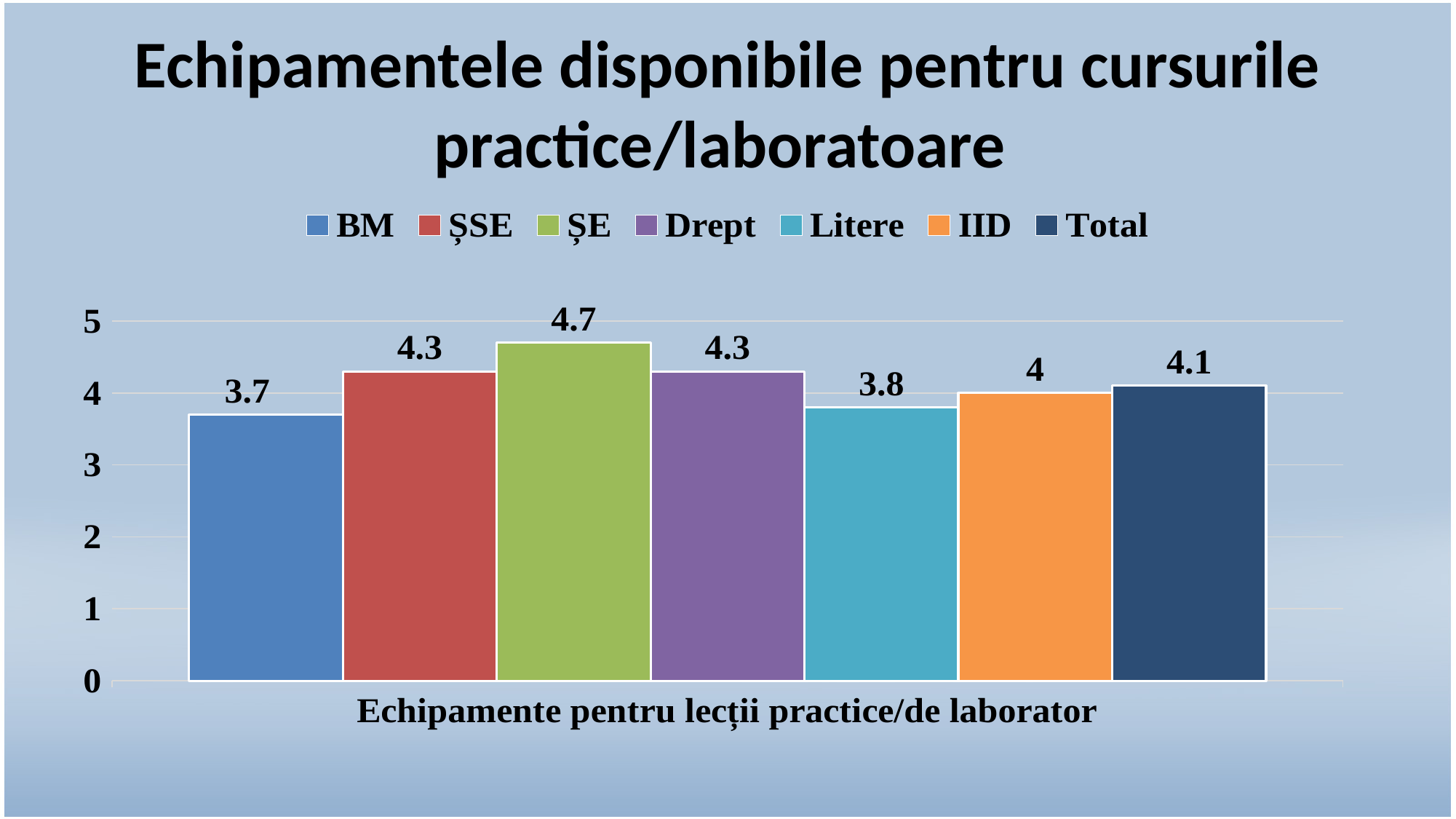
Which series has the lowest value? BM Is the value for Drept greater or less than 4? greater What is the label on the x axis of the chart? Echipamente pentru lecții practice/de laborator How many series does the legend list? 7 What is the value for BM? 3.7 What is the difference between the values for ȘE and BM? 1 Which series has the highest value? ȘE What kind of chart is shown on the slide? bar chart Which is larger, the value for IID or the value for Litere? IID What is the value for ȘE? 4.7 What is the value for Litere? 3.8 What is the value for Total? 4.1